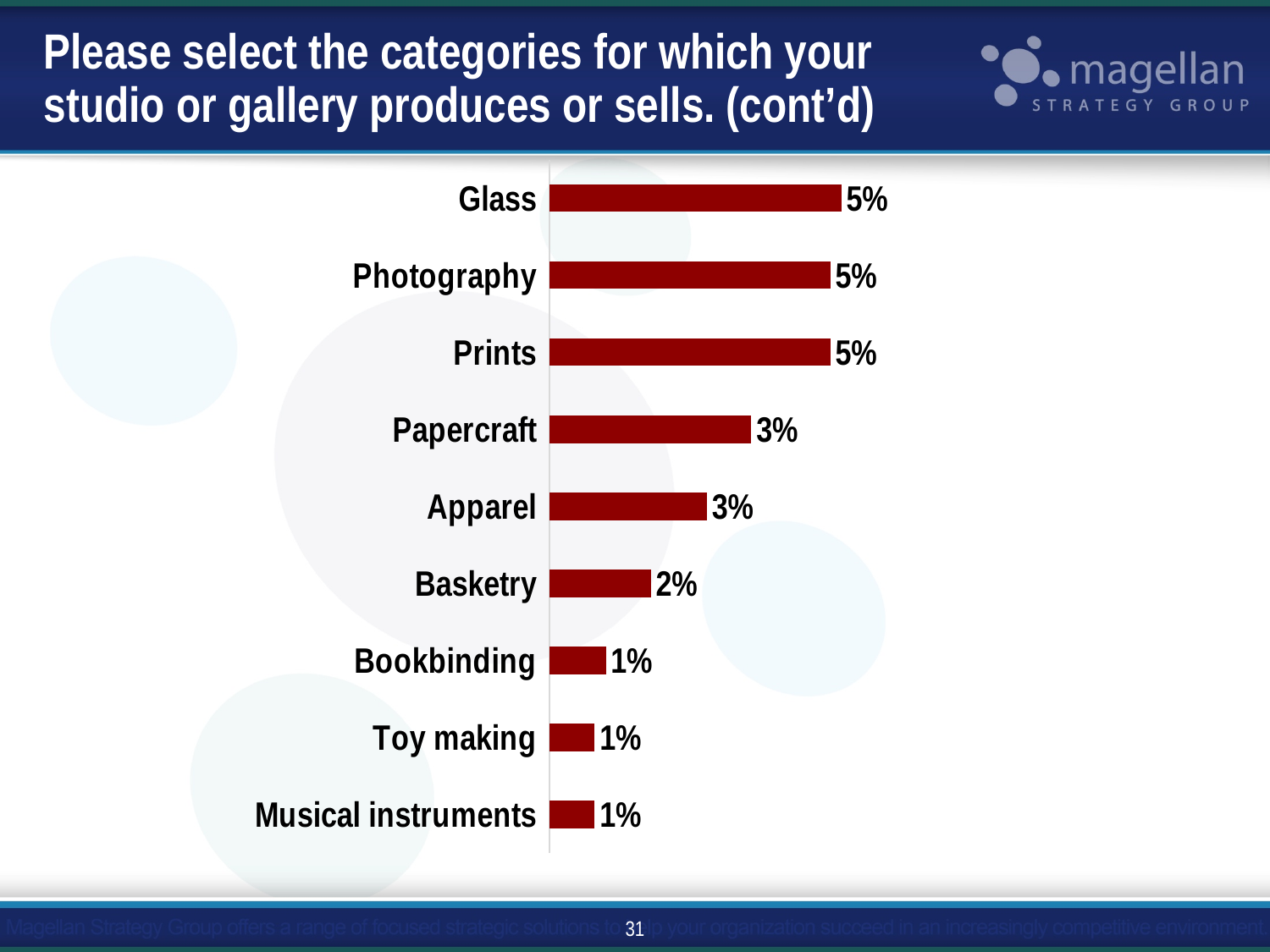
What is the value for Musical instruments? 1% What is the value for Papercraft? 3% Which is larger, the value for Basketry or the value for Apparel? Apparel Do the values rise or fall going from the top category to the bottom category? Fall What is the value for Apparel? 3% What is the difference between the value for Prints and the value for Basketry? 3 percentage points What is the value for Glass? 5% What is the difference between the value for Papercraft and the value for Toy making? 2 percentage points What kind of chart is shown on the slide? Bar chart What is the value for Basketry? 2% Which is larger, the value for Photography or the value for Bookbinding? Photography How many categories are shown in the chart? 9